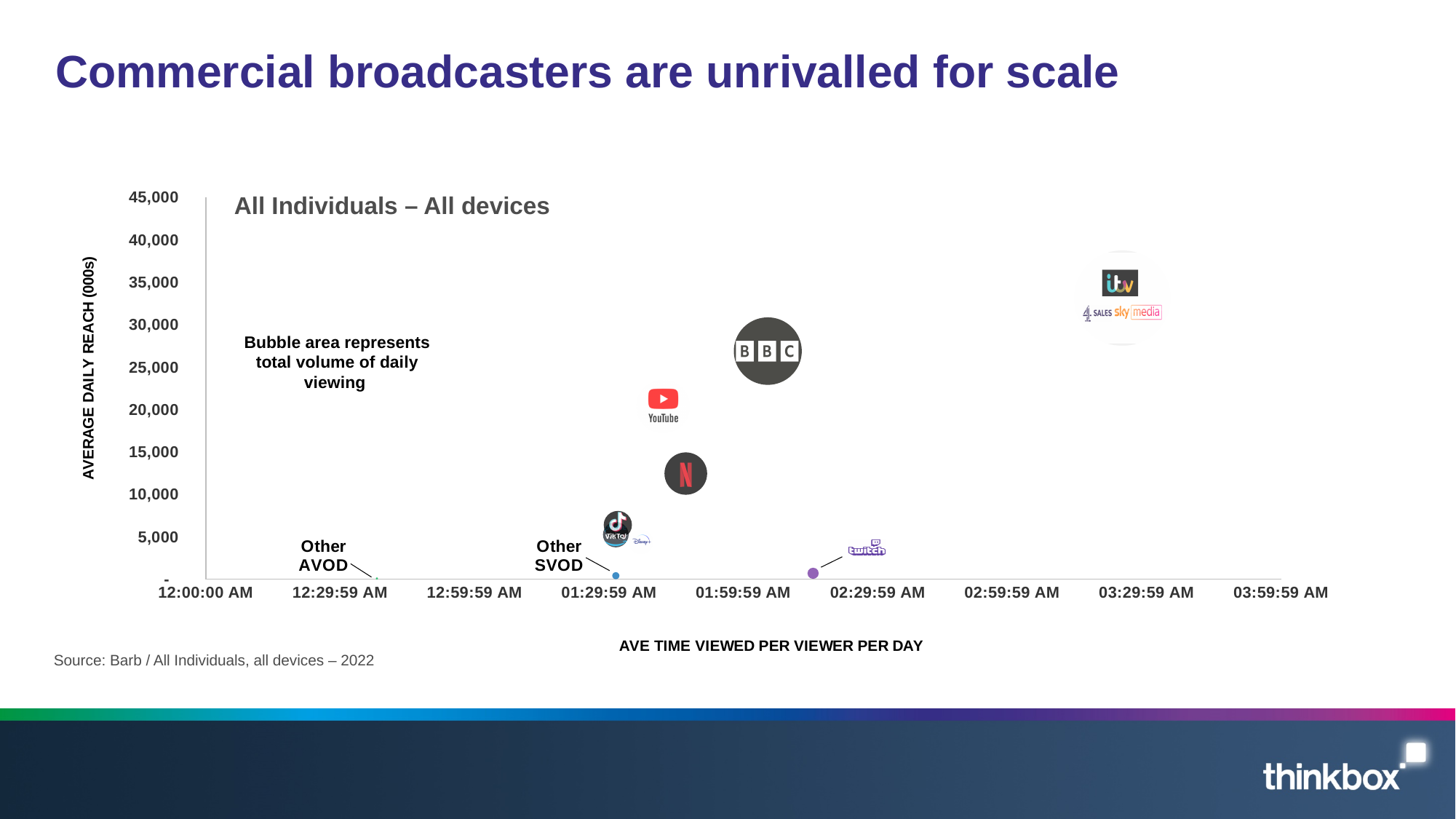
What kind of chart is shown on the slide? Bubble chart Is the average daily reach for Netflix greater or less than 10,000? greater Is the average daily reach for BBC greater or less than 25,000? greater Which has the higher average daily reach, BBC or YouTube? BBC Is the average daily reach for Twitch greater or less than 5,000? less What does the vertical axis of the chart measure? AVERAGE DAILY REACH (000s) Which bubble has the highest average daily reach? ITV / Channel 4 / Sky Media (commercial broadcasters) What is the title printed inside the chart area? All Individuals – All devices